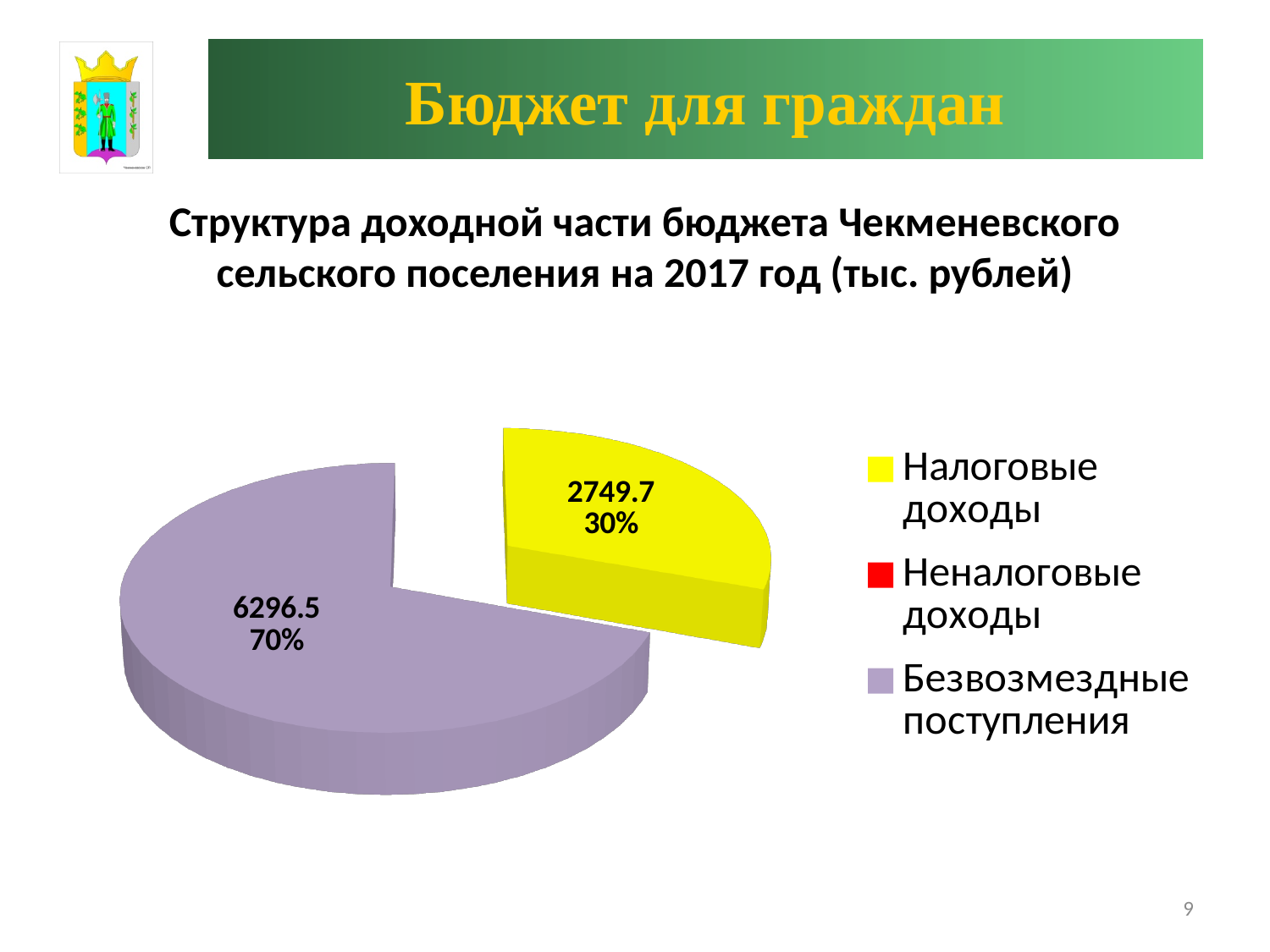
What type of chart is shown on the slide? pie chart What colour does the legend assign to Неналоговые доходы? red Which category has the largest slice of the pie? Безвозмездные поступления What share of the pie does Налоговые доходы represent? 30% What is the difference between the values for Безвозмездные поступления and Налоговые доходы? 3546.8 What is the value shown for Безвозмездные поступления? 6296.5 How many entries does the legend list? 3 What is the value shown for Налоговые доходы? 2749.7 Which of the labelled slices is the smallest? Налоговые доходы What colour is the slice for Налоговые доходы? yellow Which is larger, Налоговые доходы or Безвозмездные поступления? Безвозмездные поступления What share of the pie does Безвозмездные поступления represent? 70%